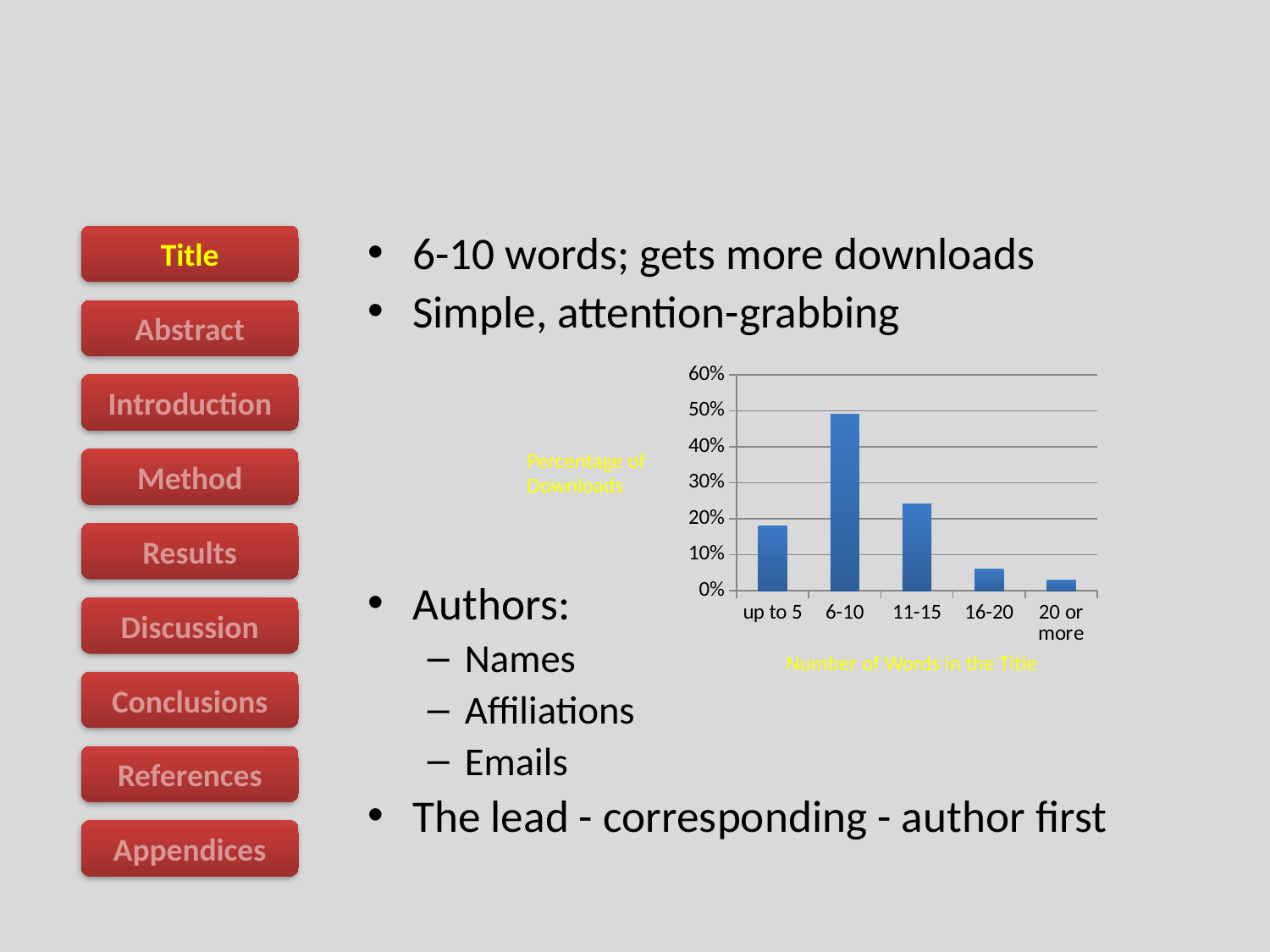
Do the values rise or fall along the x axis from 6-10 to 20 or more? fall What is the label on the x axis of the chart? Number of Words in the Title Is the value for up to 5 greater or less than 10%? greater How many categories are shown on the x axis of the chart? 5 Which title-length category has the lowest percentage of downloads? 20 or more Which title-length category has the highest percentage of downloads? 6-10 Which has a higher percentage of downloads, up to 5 or 11-15? 11-15 What kind of chart is shown on the slide? bar chart Is the value for 16-20 greater or less than 10%? less Is the value for 6-10 greater or less than 40%? greater